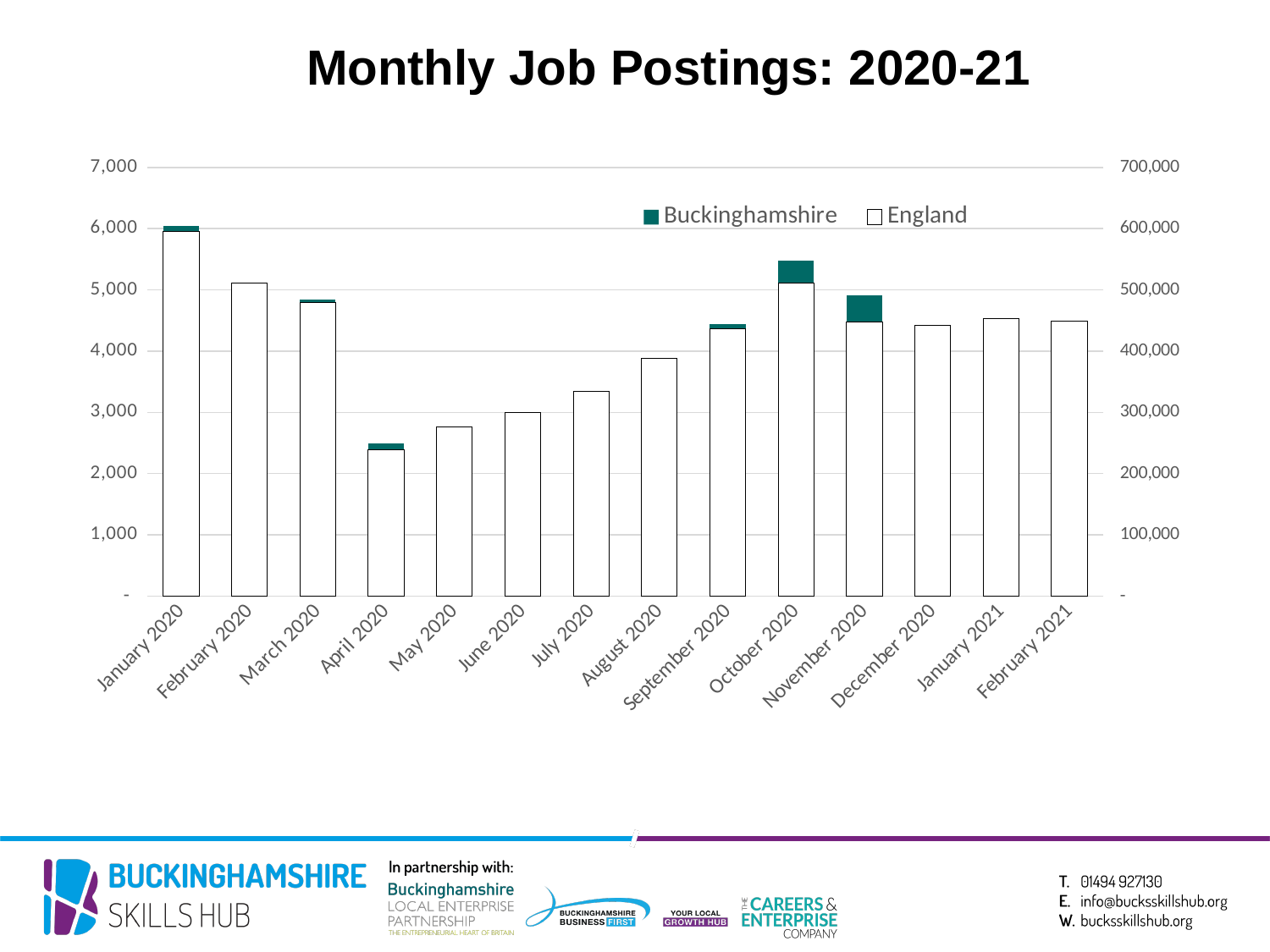
What kind of chart is shown on the slide? Bar chart Which month has the highest England job postings? January 2020 Is the Buckinghamshire value for October 2020 greater or less than 5,000? greater Which series is shown in teal in the legend? Buckinghamshire Do the England job postings rise or fall from April 2020 to October 2020? rise How many months are plotted along the x axis? 14 Which is larger for England: January 2020 or February 2020? January 2020 Is the England value for January 2020 greater or less than 500,000? greater What is the title of the chart? Monthly Job Postings: 2020-21 Which month has the lowest England job postings? April 2020 How many series does the legend list? 2 Is the England value for April 2020 greater or less than 300,000? less